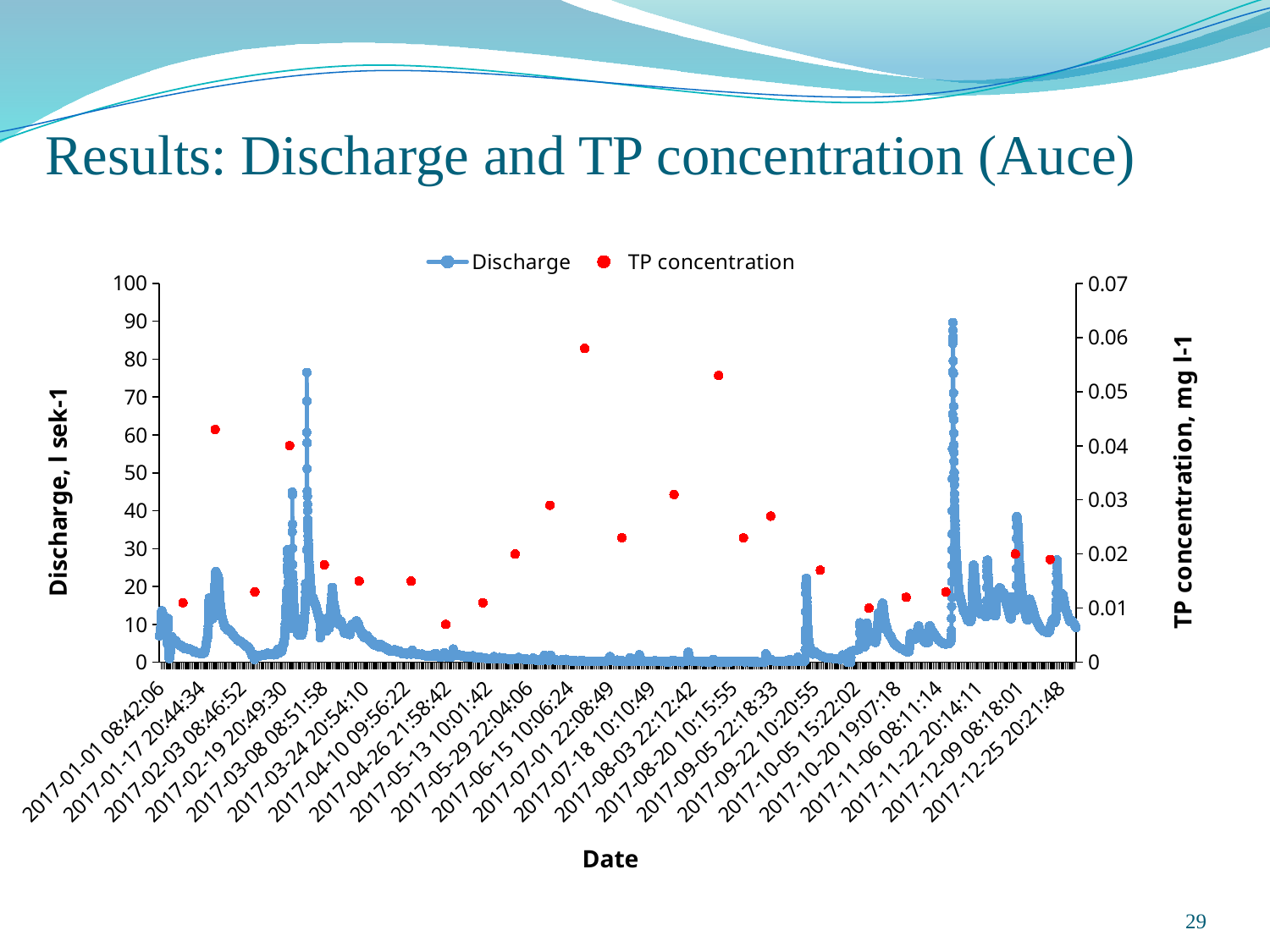
Is the highest TP concentration value greater or less than 0.05 mg l-1? greater Does the discharge rise or fall between late March and June 2017? fall In which month of 2017 does the discharge reach its highest peak? November Is the lowest TP concentration value greater or less than 0.01 mg l-1? less Is the highest discharge peak greater or less than 80 l sek-1? greater How many series does the legend list? 2 What is the title of the chart on this slide? Results: Discharge and TP concentration (Auce) What is the label of the right-hand vertical axis? TP concentration, mg l-1 What are the two series shown in the legend? Discharge and TP concentration What kind of chart is used to show the Discharge series? line chart